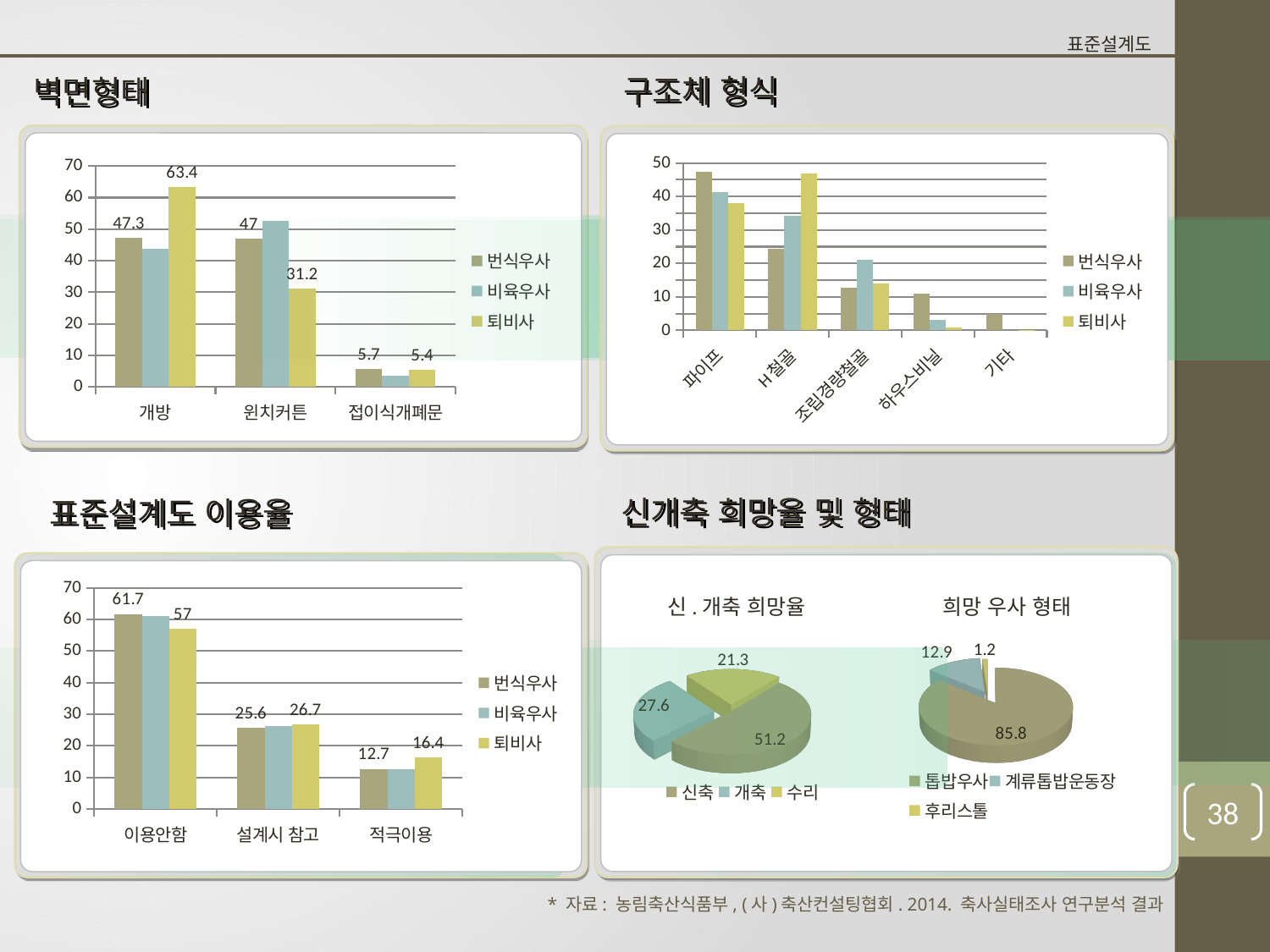
In the 구조체 형식 chart, how many categories are shown on the x axis? 5 In the 벽면형태 chart, what is the difference between the 퇴비사 values for 개방 and 윈치커튼? 32.2 In the 구조체 형식 chart, is the value of 번식우사 for 파이프 greater or less than 40? greater In the 구조체 형식 chart, which category has the highest 퇴비사 value? H철골 In the 벽면형태 chart, what is the value of 퇴비사 for 개방? 63.4 What kind of chart is the 벽면형태 chart? bar chart In the 신 . 개축 희망율 pie chart, what share does 신축 have? 51.2 In the 벽면형태 chart, what is the value of 번식우사 for 윈치커튼? 47 In the 표준설계도 이용율 chart, which is larger for 이용안함: 번식우사 or 퇴비사? 번식우사 In the 표준설계도 이용율 chart, what is the value of 퇴비사 for 적극이용? 16.4 In the 희망 우사 형태 pie chart, which slice is the largest? 톱밥우사 In the 표준설계도 이용율 chart, how many series does the legend list? 3